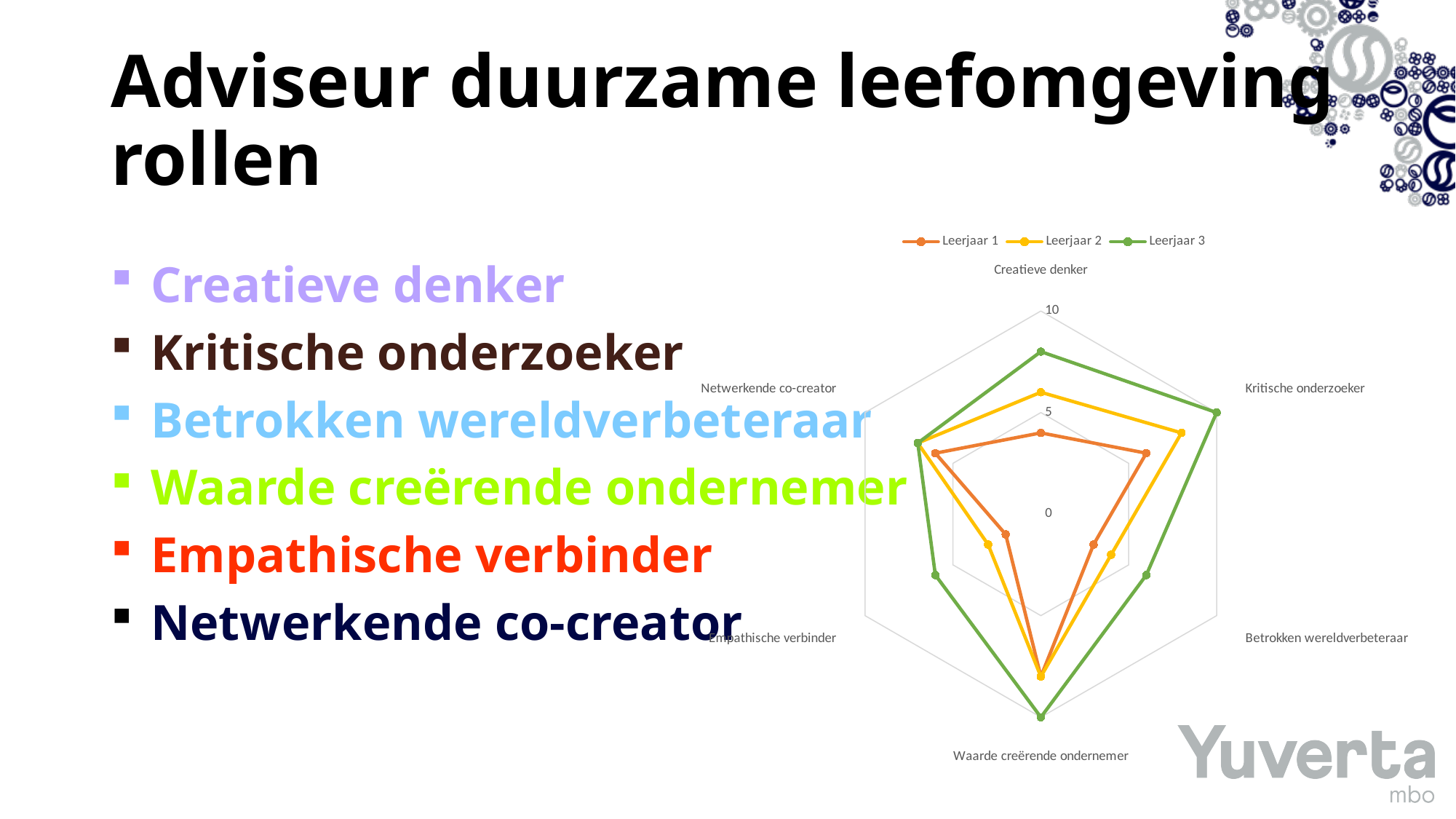
Is the value of Leerjaar 3 for Creatieve denker greater or less than 5? greater Which series has the higher value for Creatieve denker, Leerjaar 1 or Leerjaar 3? Leerjaar 3 Is the value of Leerjaar 1 for Empathische verbinder greater or less than 5? less What kind of chart is shown on the slide? Radar chart Which series are listed in the chart legend? Leerjaar 1, Leerjaar 2, Leerjaar 3 Is the value of Leerjaar 1 for Betrokken wereldverbeteraar greater or less than 5? less Which series has the higher value for Betrokken wereldverbeteraar, Leerjaar 2 or Leerjaar 3? Leerjaar 3 How many series does the chart legend list? 3 How many categories (axes) does the radar chart have? 6 For the Leerjaar 1 series, which category has the highest value? Waarde creërende ondernemer What is the highest value shown on the chart's axis scale? 10